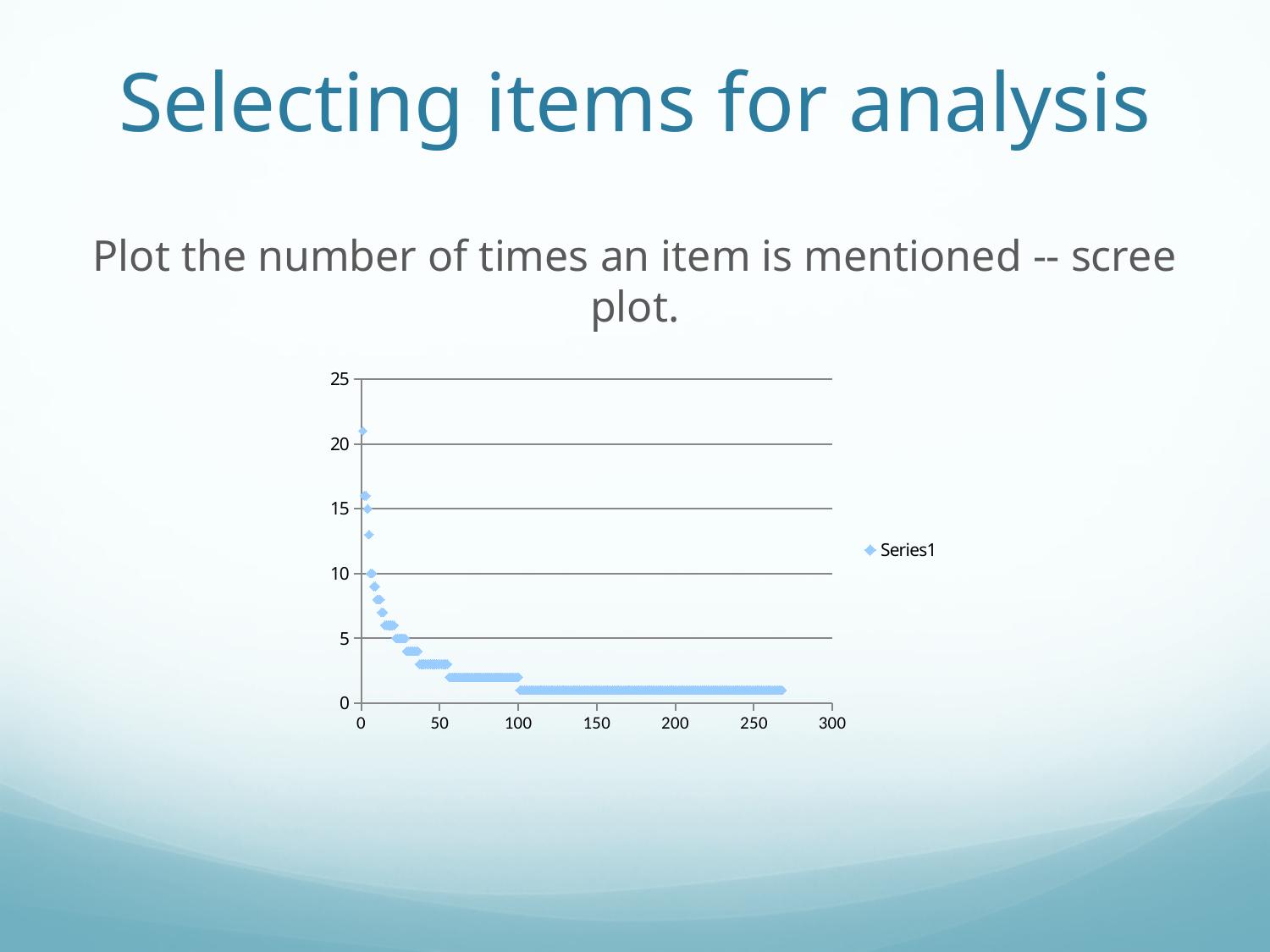
What kind of chart is shown on the slide? scatter plot Is the highest plotted value greater or less than 15? greater Is the x position of the rightmost plotted point greater or less than 250? greater What is the highest tick value shown on the y axis? 25 What is the name of the series shown in the legend? Series1 Do the plotted values rise or fall as you move along the x axis? fall Is the plotted value at x = 150 greater or less than 10? less How many series does the legend list? 1